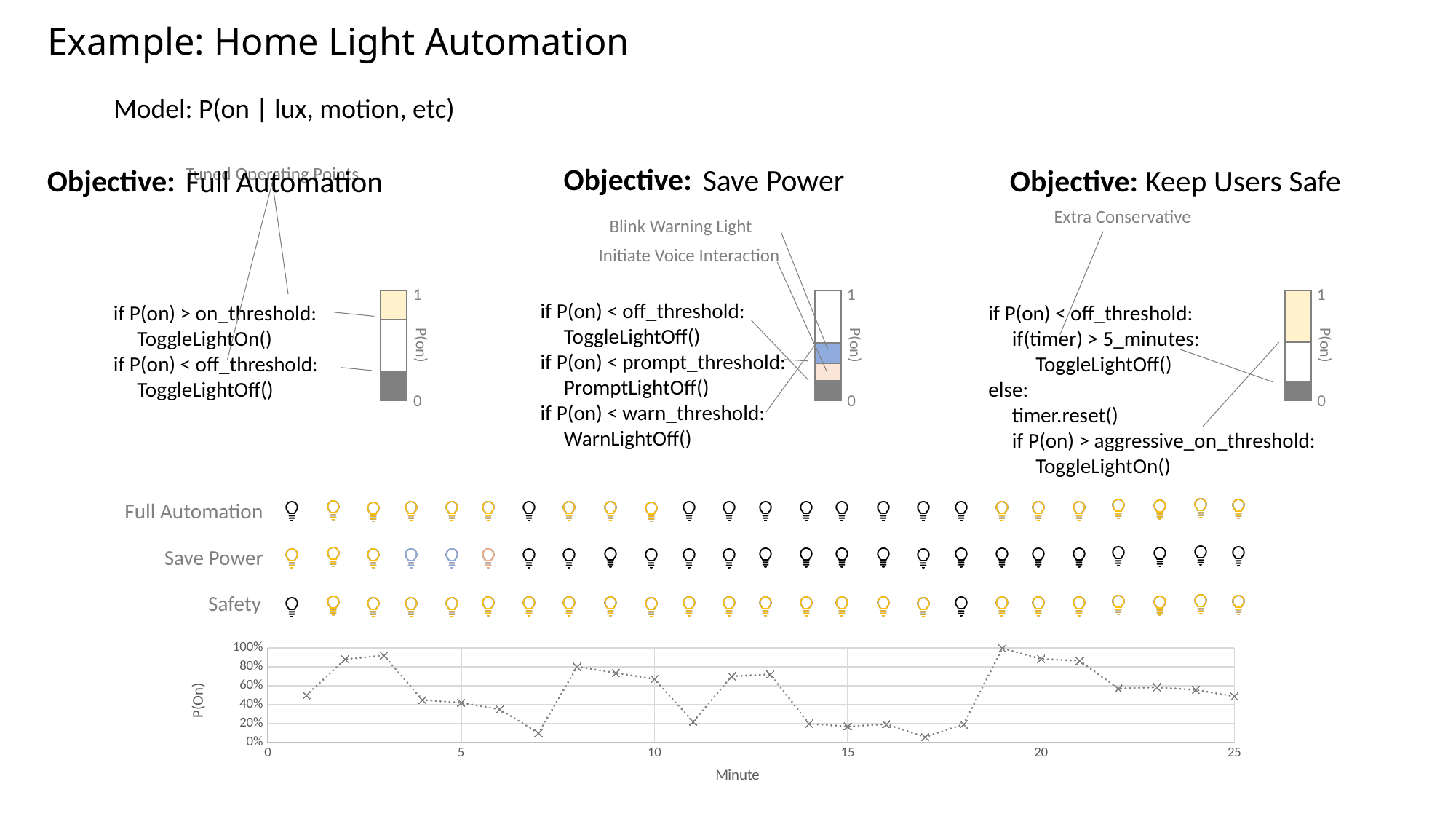
In the bottom chart, at which minute is P(On) highest? 19 In the bottom chart, does P(On) rise or fall between minute 17 and minute 19? rise In the bottom chart, is the value at minute 7 greater or less than 20%? less What kind of chart is shown at the bottom of the slide? line chart In the bottom chart, what is the label of the y axis? P(On) In the bottom chart, how many data points are plotted? 25 In the bottom chart, what is the label of the x axis? Minute In the bottom chart, does P(On) rise or fall between minute 3 and minute 7? fall In the bottom chart, is the value at minute 3 greater or less than 80%? greater In the bottom chart, which has the larger P(On): minute 7 or minute 8? minute 8 In the bottom chart, is the value at minute 19 greater or less than 80%? greater